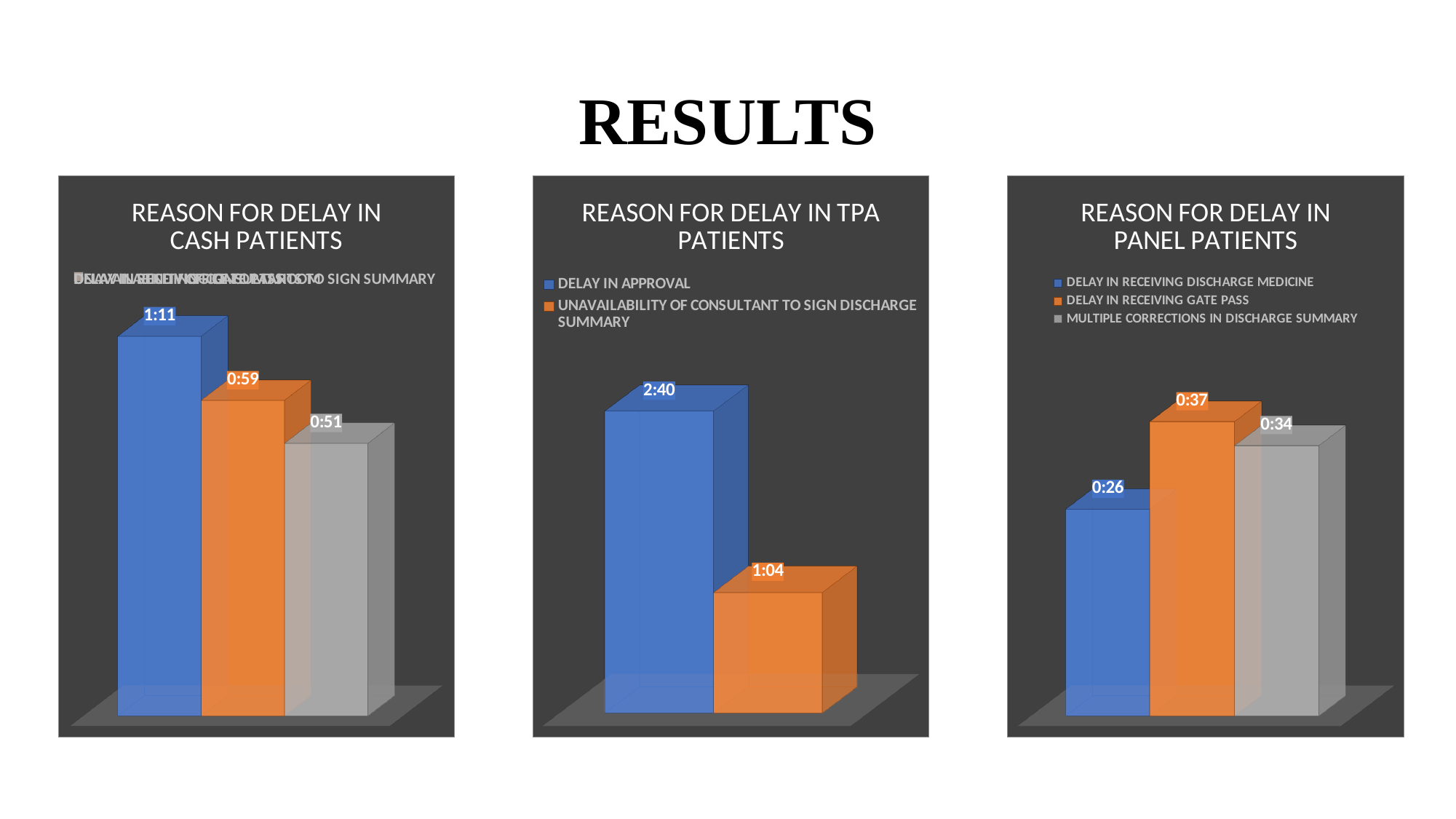
In the 'Reason for delay in TPA patients' chart, how many bars are plotted? 2 In the 'Reason for delay in panel patients' chart, what is the value for Delay in receiving gate pass? 0:37 In the 'Reason for delay in TPA patients' chart, what is the value for Delay in approval? 2:40 In the 'Reason for delay in panel patients' chart, how many reasons does the legend list? 3 In the 'Reason for delay in panel patients' chart, what is the value for Delay in receiving discharge medicine? 0:26 In the 'Reason for delay in TPA patients' chart, what is the difference between Delay in approval and Unavailability of consultant to sign discharge summary? 1:36 In the 'Reason for delay in panel patients' chart, which reason has the lowest value? Delay in receiving discharge medicine In the 'Reason for delay in cash patients' chart, what is the value shown on the tallest (blue) bar? 1:11 What type of chart is the 'Reason for delay in cash patients' chart? Bar chart In the 'Reason for delay in panel patients' chart, what is the value for Multiple corrections in discharge summary? 0:34 In the 'Reason for delay in TPA patients' chart, what is the value for Unavailability of consultant to sign discharge summary? 1:04 In the 'Reason for delay in panel patients' chart, which reason has the highest value? Delay in receiving gate pass